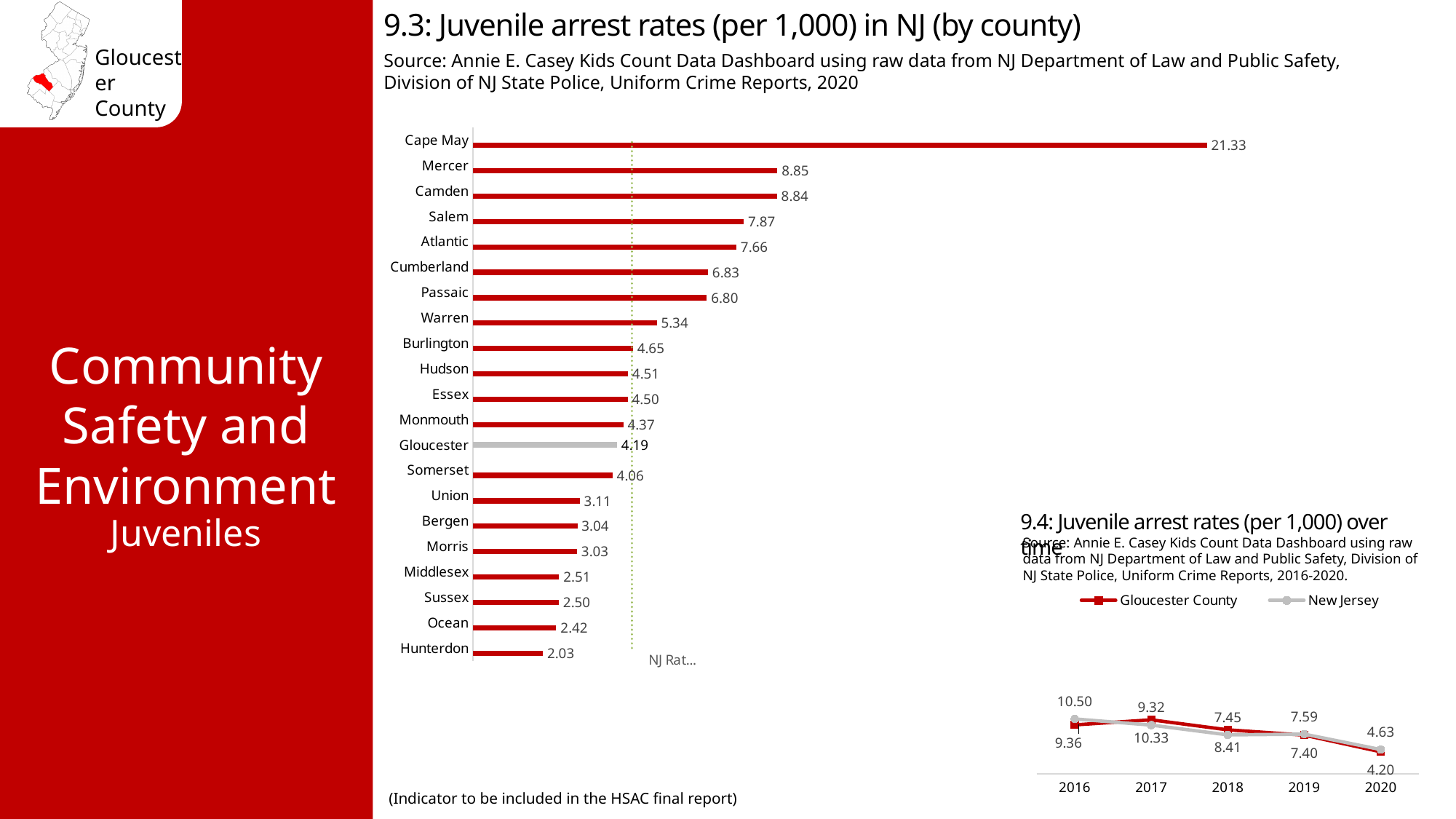
In the chart '9.3: Juvenile arrest rates (per 1,000) in NJ (by county)', which has a higher value, Salem or Passaic? Salem In the chart '9.3: Juvenile arrest rates (per 1,000) in NJ (by county)', which county has the lowest juvenile arrest rate? Hunterdon In the chart '9.3: Juvenile arrest rates (per 1,000) in NJ (by county)', how many counties are shown? 21 In the chart '9.3: Juvenile arrest rates (per 1,000) in NJ (by county)', which county's bar is shown in gray instead of red? Gloucester What kind of chart is '9.3: Juvenile arrest rates (per 1,000) in NJ (by county)'? Bar chart In the chart '9.3: Juvenile arrest rates (per 1,000) in NJ (by county)', what is the difference between the values for Cape May and Mercer? 12.48 In the chart '9.3: Juvenile arrest rates (per 1,000) in NJ (by county)', which county has the highest juvenile arrest rate? Cape May In the chart '9.4: Juvenile arrest rates (per 1,000) over time', how many series does the legend list? 2 In the chart '9.3: Juvenile arrest rates (per 1,000) in NJ (by county)', what is the value for Cumberland? 6.83 In the chart '9.4: Juvenile arrest rates (per 1,000) over time', do the values generally rise or fall from 2016 to 2020? Fall In the chart '9.3: Juvenile arrest rates (per 1,000) in NJ (by county)', what is the value for Gloucester? 4.19 In the chart '9.4: Juvenile arrest rates (per 1,000) over time', how many years are shown on the x axis? 5